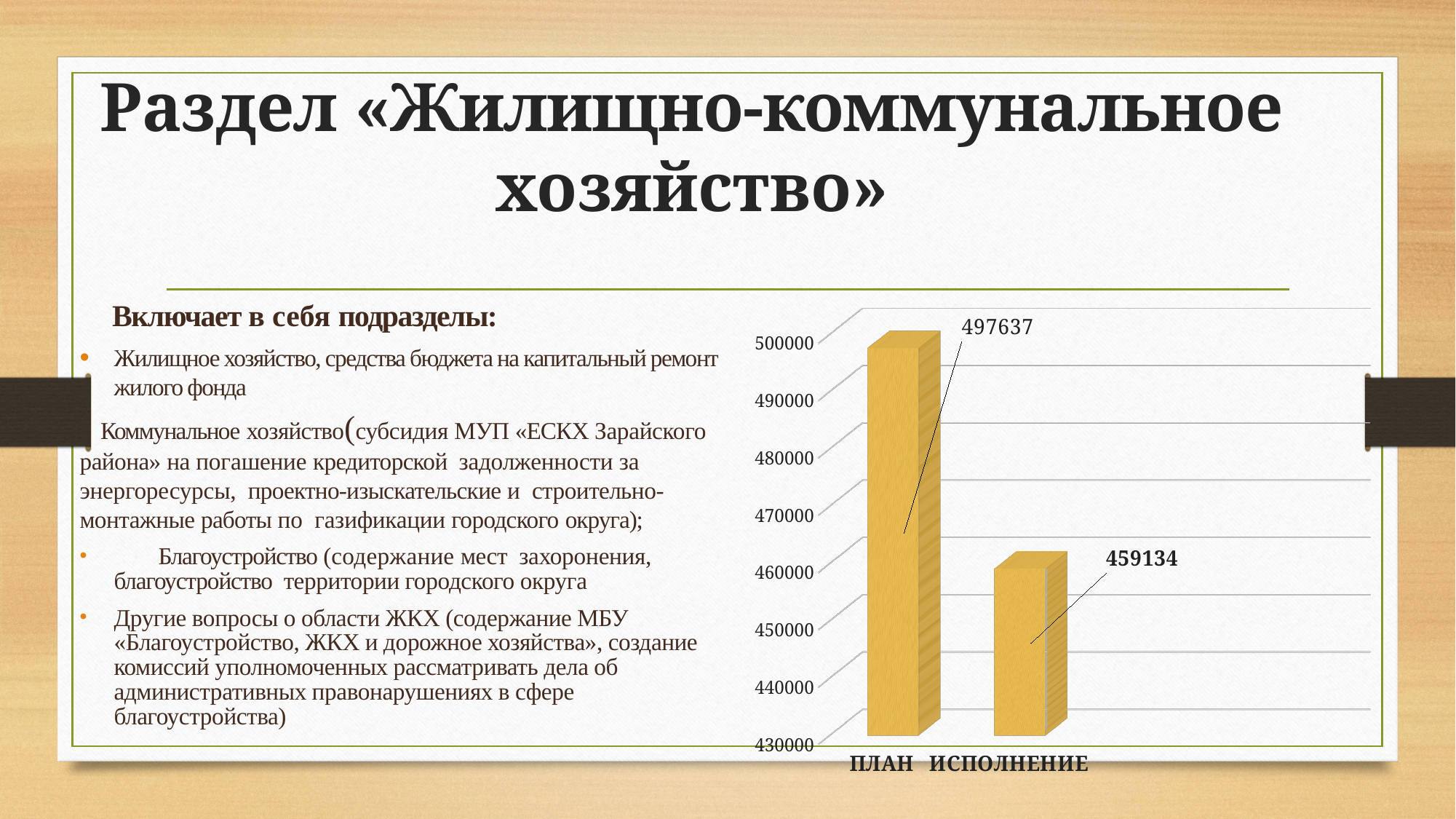
Is the value for ПЛАН greater or less than 490000? greater Is the value for ИСПОЛНЕНИЕ greater or less than 470000? less Which is larger, the value for ПЛАН or the value for ИСПОЛНЕНИЕ? ПЛАН What is the value for ИСПОЛНЕНИЕ? 459134 What is the value for ПЛАН? 497637 What is the difference between the values for ПЛАН and ИСПОЛНЕНИЕ? 38503 What is the lowest value shown on the vertical axis of the chart? 430000 How many categories are shown on the chart? 2 Which category has the lowest value? ИСПОЛНЕНИЕ Which category has the highest value? ПЛАН Do the values rise or fall from ПЛАН to ИСПОЛНЕНИЕ? fall What kind of chart is shown on the slide? bar chart